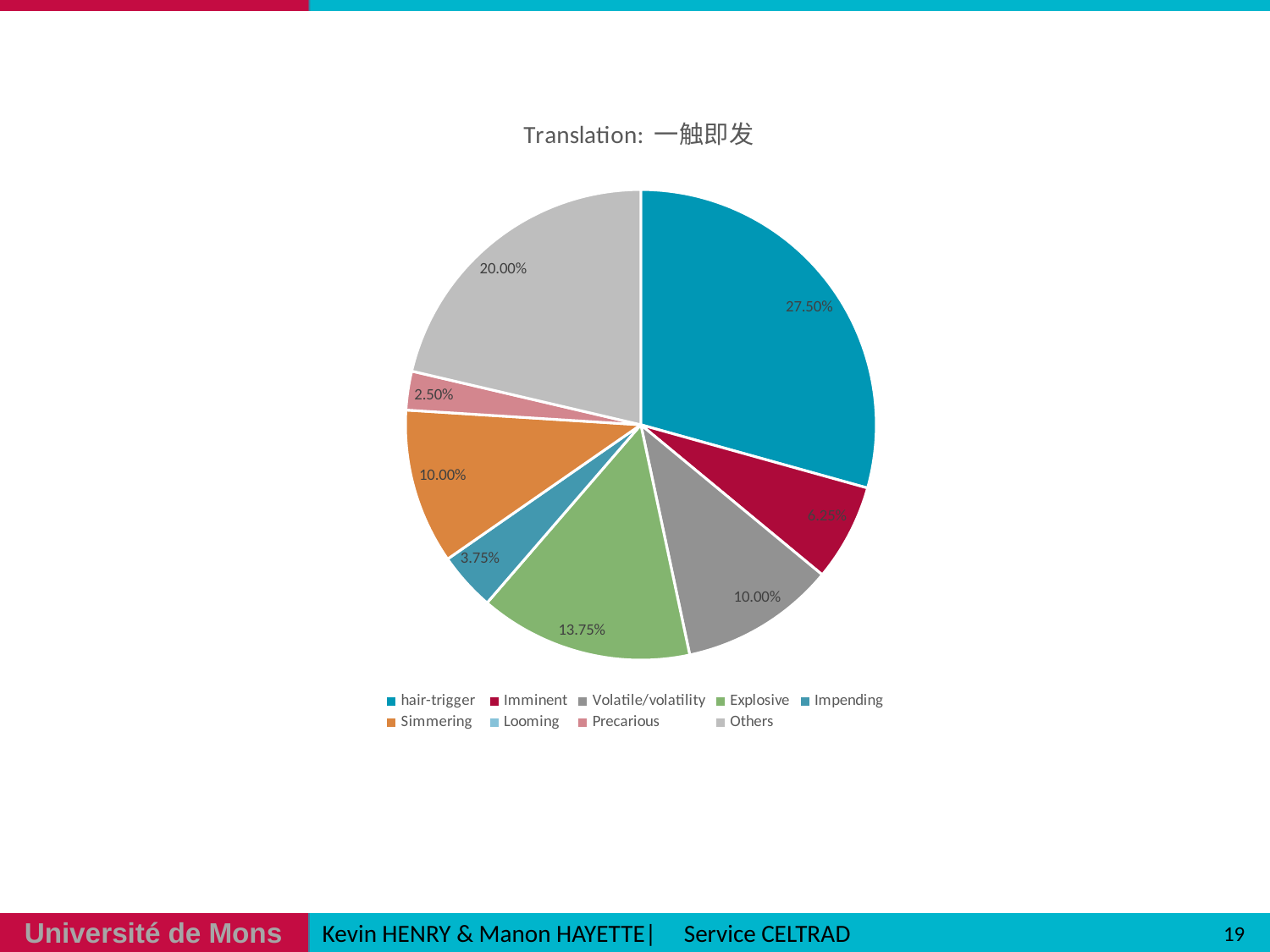
Which has the larger share, Explosive or Simmering? Explosive Which category has the largest share of the pie? hair-trigger How many percentage points larger is the hair-trigger share than the Others share? 7.50% What percentage of the pie does Explosive account for? 13.75% What is the title of the chart? Translation: 一触即发 What percentage of the pie does Others account for? 20.00% What percentage of the pie does Impending account for? 3.75% What percentage of the pie does hair-trigger account for? 27.50% How many entries does the legend list? 9 What kind of chart is shown on the slide? pie chart What percentage of the pie does Simmering account for? 10.00% What percentage of the pie does Precarious account for? 2.50%